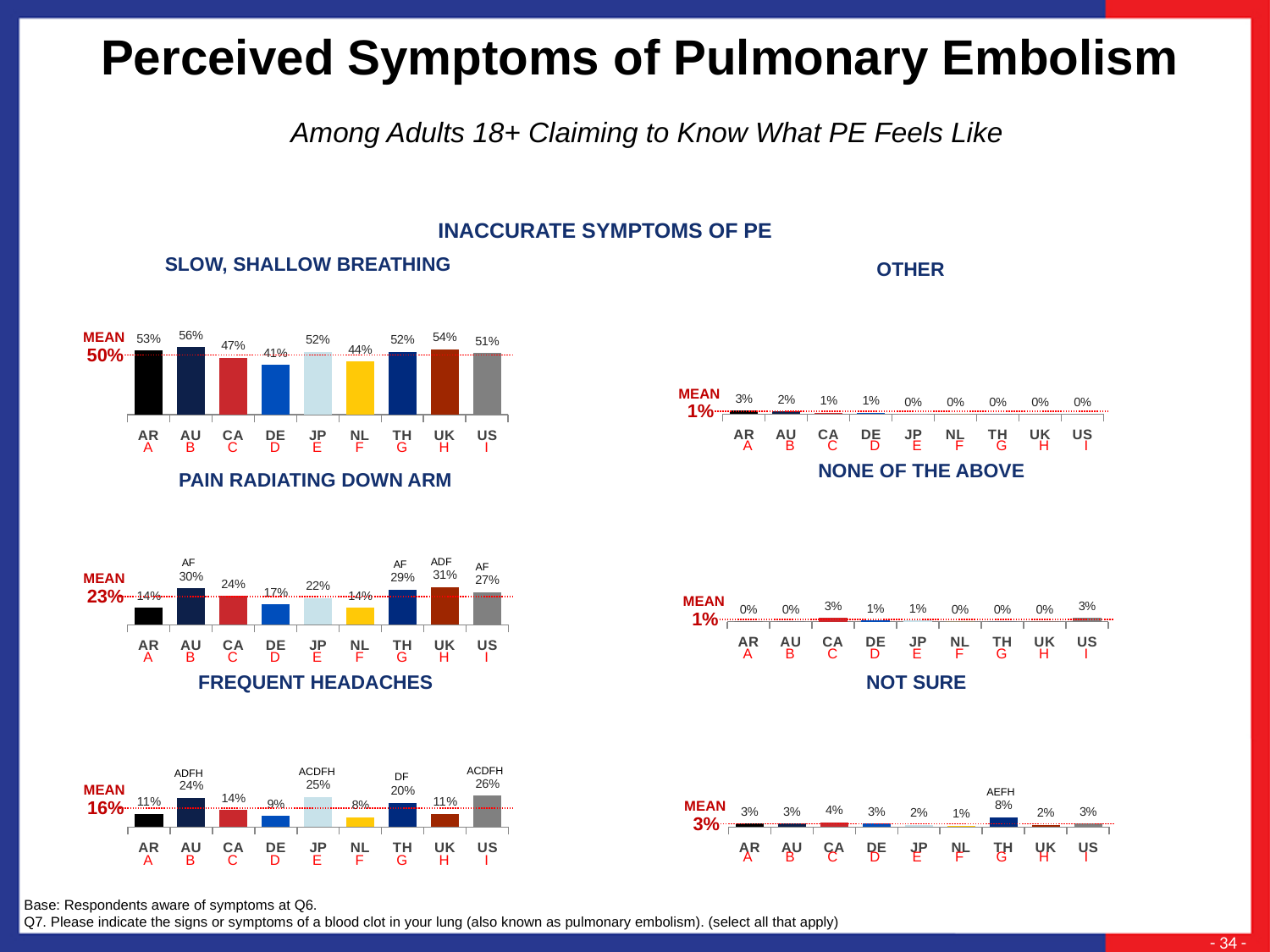
In the Slow, Shallow Breathing chart, what is the value for AU? 56% In the Slow, Shallow Breathing chart, what is the difference between the values for UK and CA? 7% In the Frequent Headaches chart, which is larger, the value for AU or the value for TH? AU In the Frequent Headaches chart, what is the mean value shown? 16% In the Pain Radiating Down Arm chart, which country has the highest value? UK In the Frequent Headaches chart, what is the value for NL? 8% How many countries are shown in the None of the Above chart? 9 In the Other chart, what is the value for AR? 3% What type of chart is the Pain Radiating Down Arm chart? Bar chart In the Pain Radiating Down Arm chart, what is the value for JP? 22% In the Slow, Shallow Breathing chart, which country has the lowest value? DE In the Not Sure chart, which country has the highest value? TH